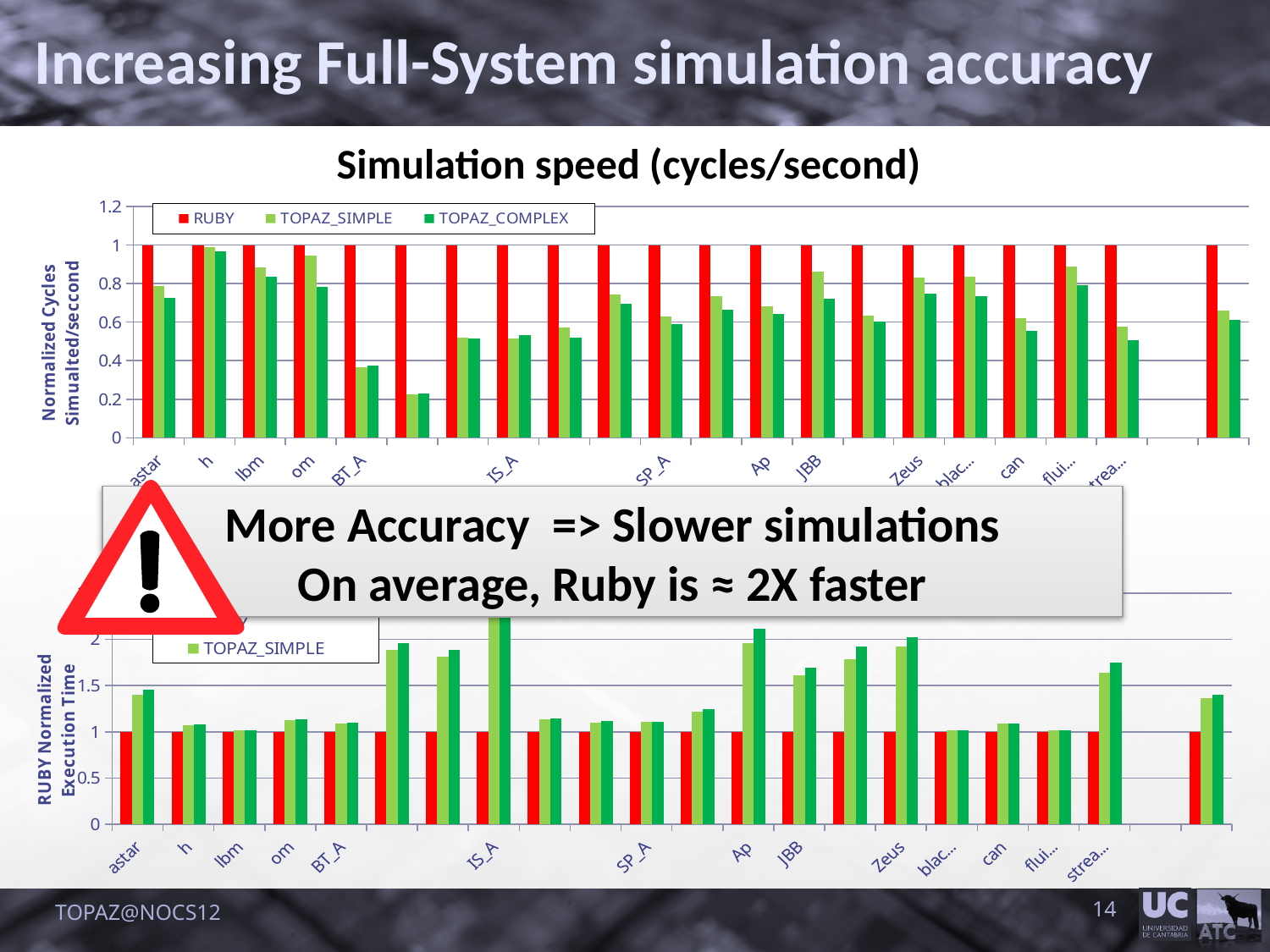
In the top chart "Simulation speed (cycles/second)", how many series does the legend list? 3 In the top chart "Simulation speed (cycles/second)", what is the RUBY value for astar? 1 What kind of chart is the top chart titled "Simulation speed (cycles/second)"? bar chart In the top chart "Simulation speed (cycles/second)", is the TOPAZ_SIMPLE value for h greater or less than 0.8? greater What is the y-axis label of the bottom chart? RUBY Normalized Execution Time In the bottom chart, which is larger: the TOPAZ_SIMPLE value for IS_A or the TOPAZ_SIMPLE value for h? IS_A In the bottom chart, is the TOPAZ_SIMPLE value for IS_A greater or less than 2? greater In the top chart "Simulation speed (cycles/second)", is the TOPAZ_COMPLEX value for BT_A greater or less than 0.6? less In the top chart "Simulation speed (cycles/second)", which series are listed in the legend? RUBY, TOPAZ_SIMPLE, TOPAZ_COMPLEX In the top chart "Simulation speed (cycles/second)", which is larger: the TOPAZ_SIMPLE value for h or the TOPAZ_SIMPLE value for BT_A? h